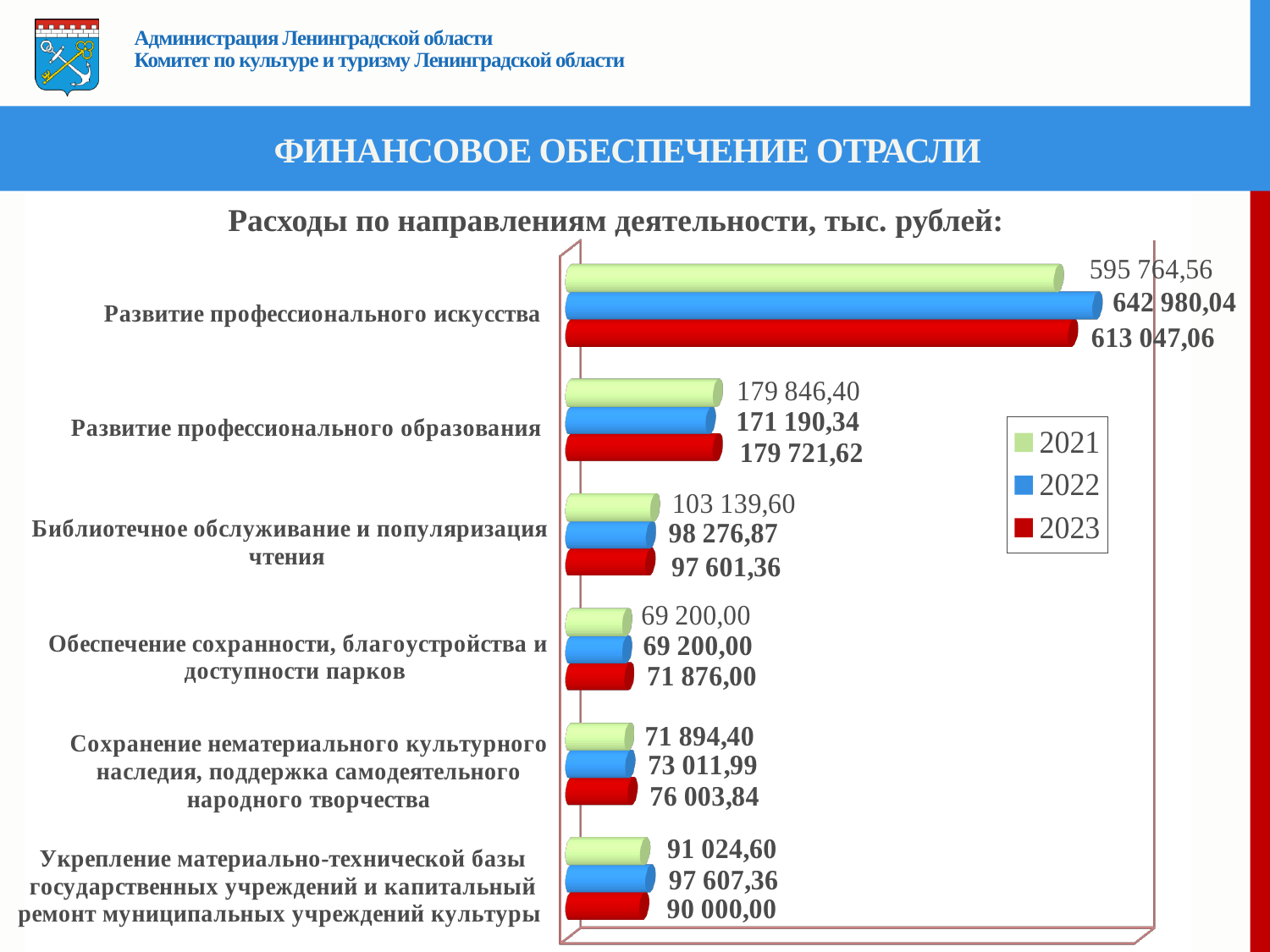
What is the 2021 value for Укрепление материально-технической базы государственных учреждений и капитальный ремонт муниципальных учреждений культуры? 91 024,60 What is the 2022 value for Развитие профессионального искусства? 642 980,04 For Библиотечное обслуживание и популяризация чтения, which year has the larger value, 2021 or 2023? 2021 How many series does the legend list? 3 What is the title of the chart? Расходы по направлениям деятельности, тыс. рублей: How many categories are shown in the chart? 6 Which category has the lowest 2023 value? Обеспечение сохранности, благоустройства и доступности парков Which category has the highest 2022 value? Развитие профессионального искусства What is the difference between the 2022 and 2023 values for Развитие профессионального искусства? 29 932,98 What kind of chart is shown on the slide? Bar chart What is the difference between the 2023 and 2021 values for Сохранение нематериального культурного наследия, поддержка самодеятельного народного творчества? 4 109,44 What is the 2023 value for Библиотечное обслуживание и популяризация чтения? 97 601,36